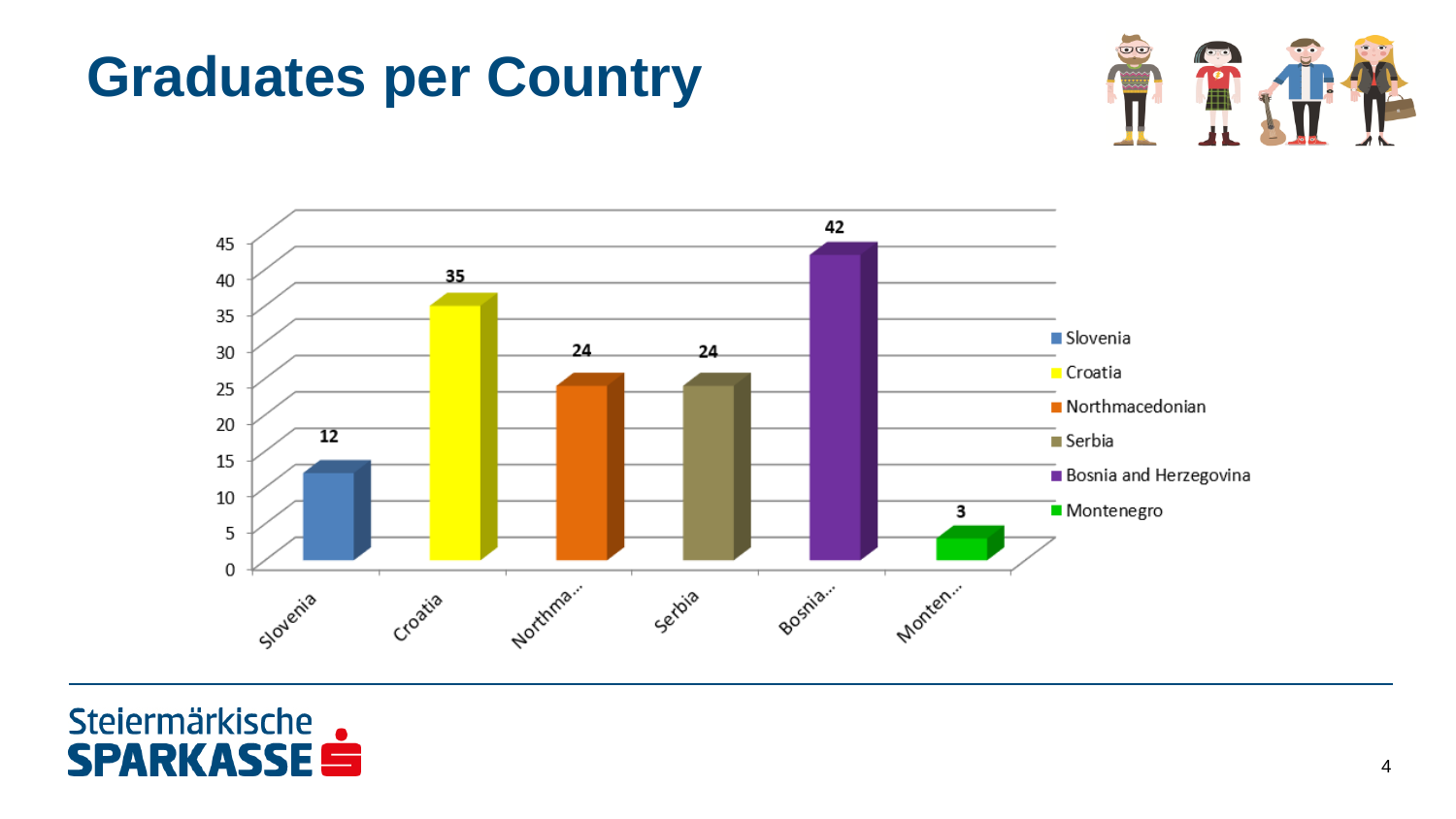
What is the value shown for Montenegro? 3 What is the value shown for Bosnia and Herzegovina? 42 Which country has the highest number of graduates? Bosnia and Herzegovina Which country has the lowest number of graduates? Montenegro What kind of chart is shown on the slide? Bar chart What is the difference between the values for Croatia and Slovenia? 23 How many graduates does the chart show for Croatia? 35 Which has a larger value, Croatia or Serbia? Croatia How many countries are shown in the chart? 6 What is the difference between the values for Bosnia and Herzegovina and Croatia? 7 Which has a larger value, Slovenia or Montenegro? Slovenia What colour is the bar for Bosnia and Herzegovina? Purple